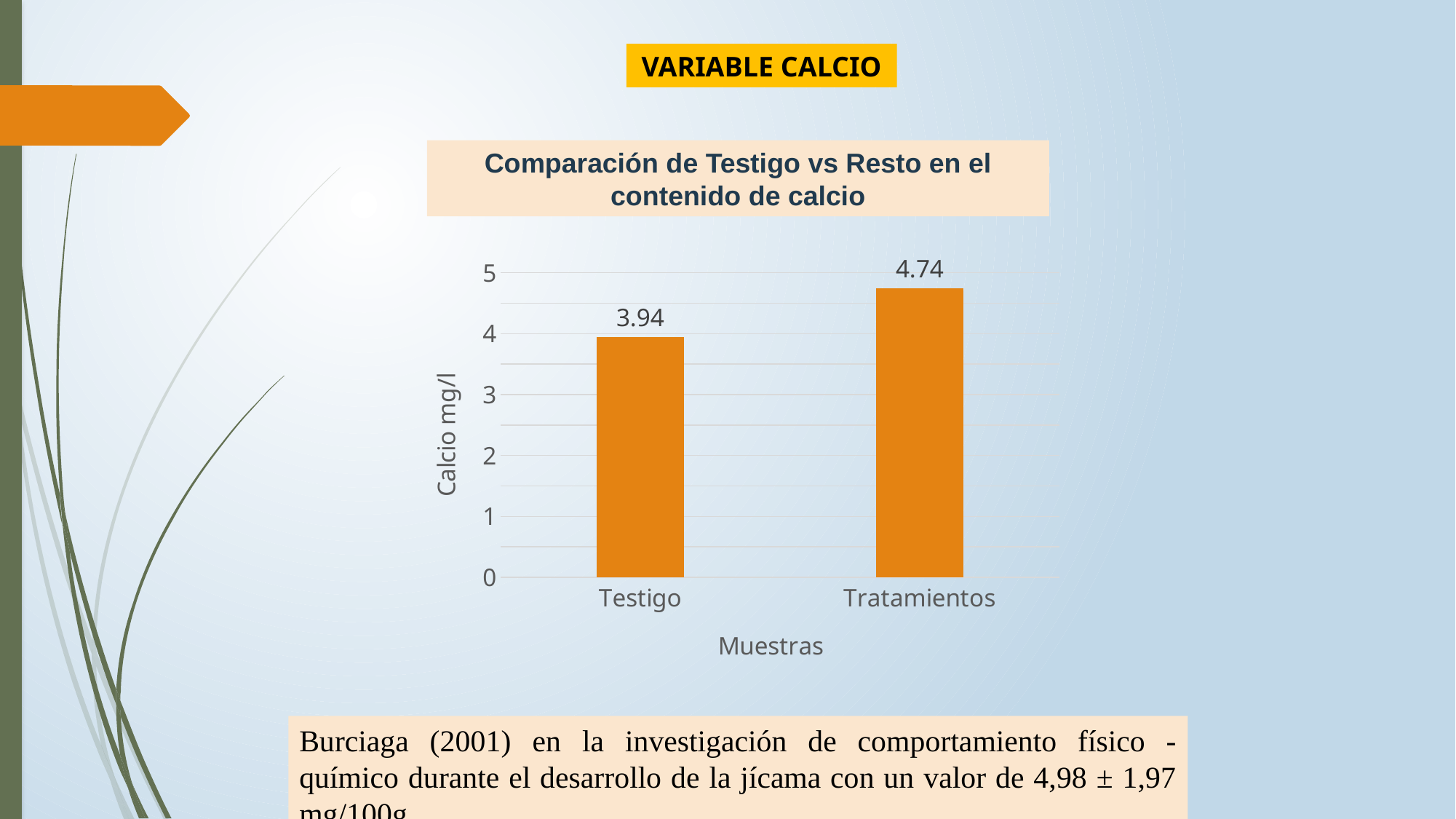
What kind of chart is shown on the slide? bar chart What is the value for Tratamientos? 4.74 How many categories are shown on the x axis? 2 Is the value for Tratamientos greater or less than 4? greater Which category has the highest calcium value? Tratamientos What is the value for Testigo? 3.94 Which is larger, the value for Testigo or the value for Tratamientos? Tratamientos What is the difference between the values for Tratamientos and Testigo? 0.80 What is the title of the chart? Comparación de Testigo vs Resto en el contenido de calcio Is the value for Testigo greater or less than 4? less Which category has the lowest calcium value? Testigo What is the label of the y axis? Calcio mg/l